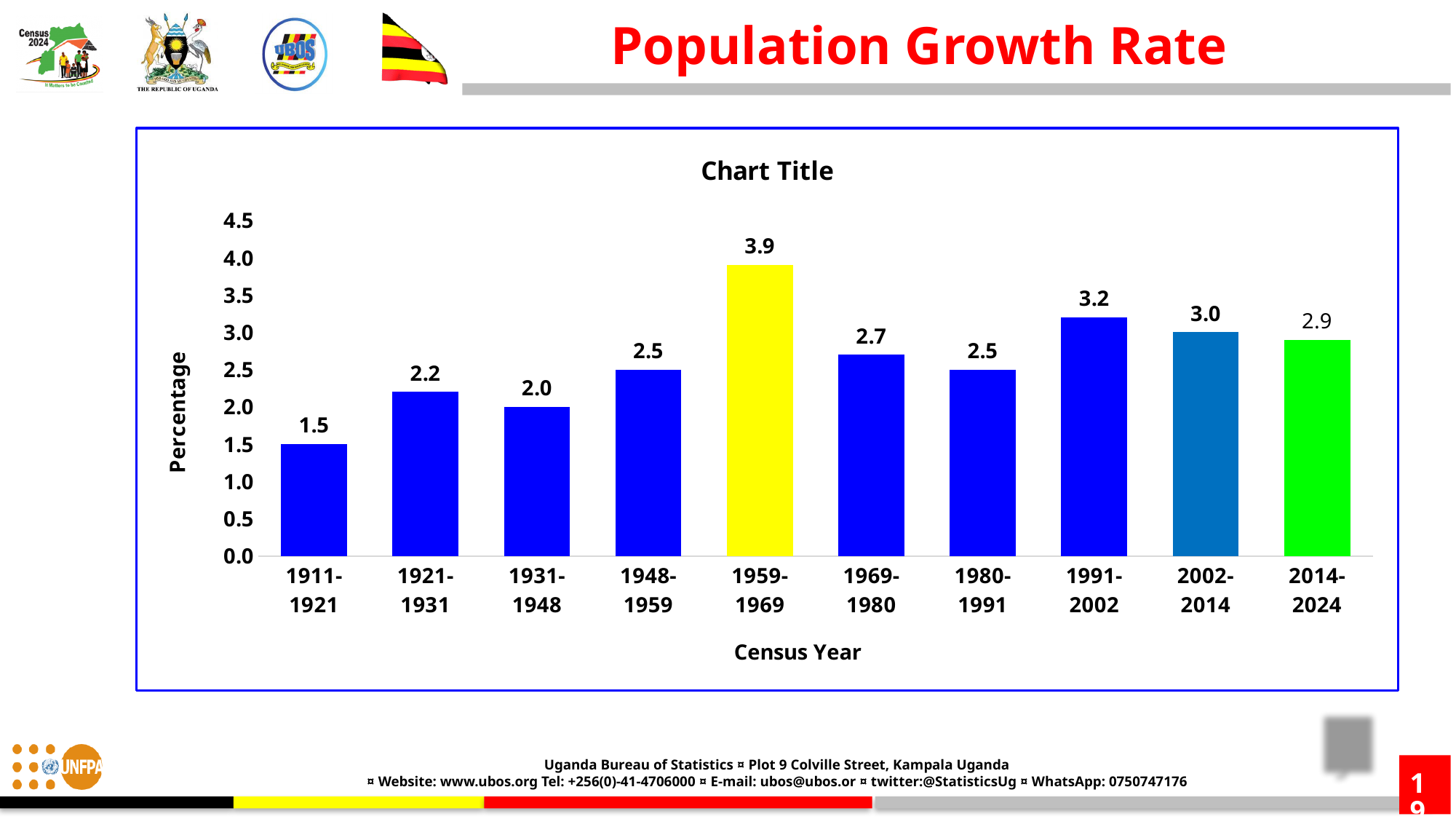
What is the label on the y axis of the chart? Percentage What is the population growth rate for the census period 1959-1969? 3.9 Does the population growth rate rise or fall from 1911-1921 to 1959-1969? Rise What colour is the bar for the 1959-1969 census period? Yellow Which is larger, the growth rate for 1991-2002 or the growth rate for 2002-2014? 1991-2002 What is the population growth rate for the census period 1911-1921? 1.5 What is the population growth rate for the census period 2014-2024? 2.9 What kind of chart is shown on the slide? Bar chart Which census period has the highest population growth rate? 1959-1969 What is the difference between the growth rate for 1959-1969 and the growth rate for 1969-1980? 1.2 Which census period has the lowest population growth rate? 1911-1921 How many census periods are shown on the chart? 10